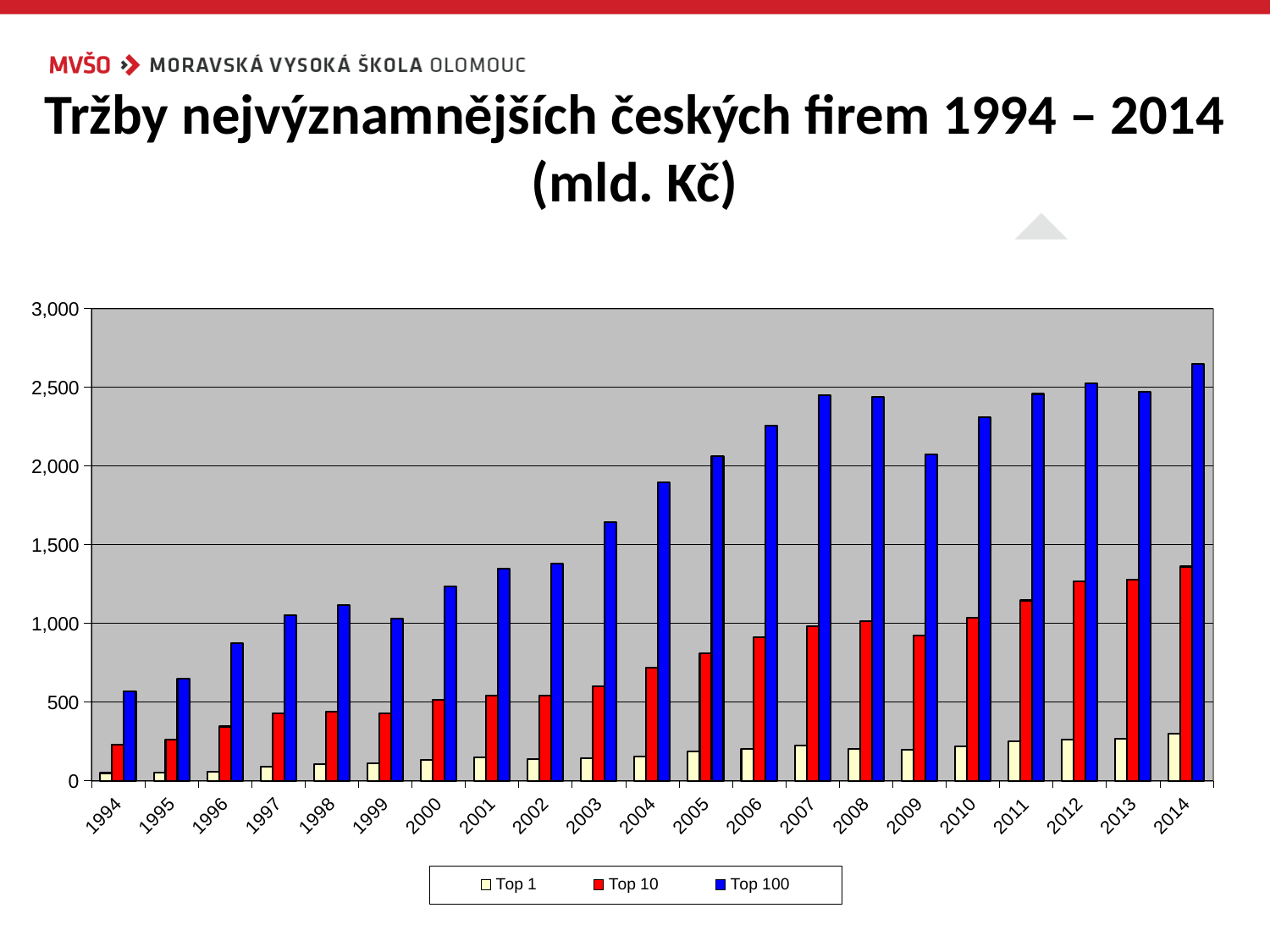
Is the value for Top 10 in 2014 greater or less than 1,500? less Is the value for Top 100 in 2014 greater or less than 2,500? greater Is the value for Top 1 in 2014 greater or less than 500? less How many years are shown on the x axis? 21 Which year has the highest value for Top 10? 2014 Which year has the highest value for Top 100? 2014 How many series does the legend list? 3 Does the Top 100 series generally rise or fall from 1994 to 2014? rise What kind of chart is shown on the slide? bar chart Which is larger, the Top 100 value for 2007 or for 2009? 2007 Which year has the lowest value for Top 100? 1994